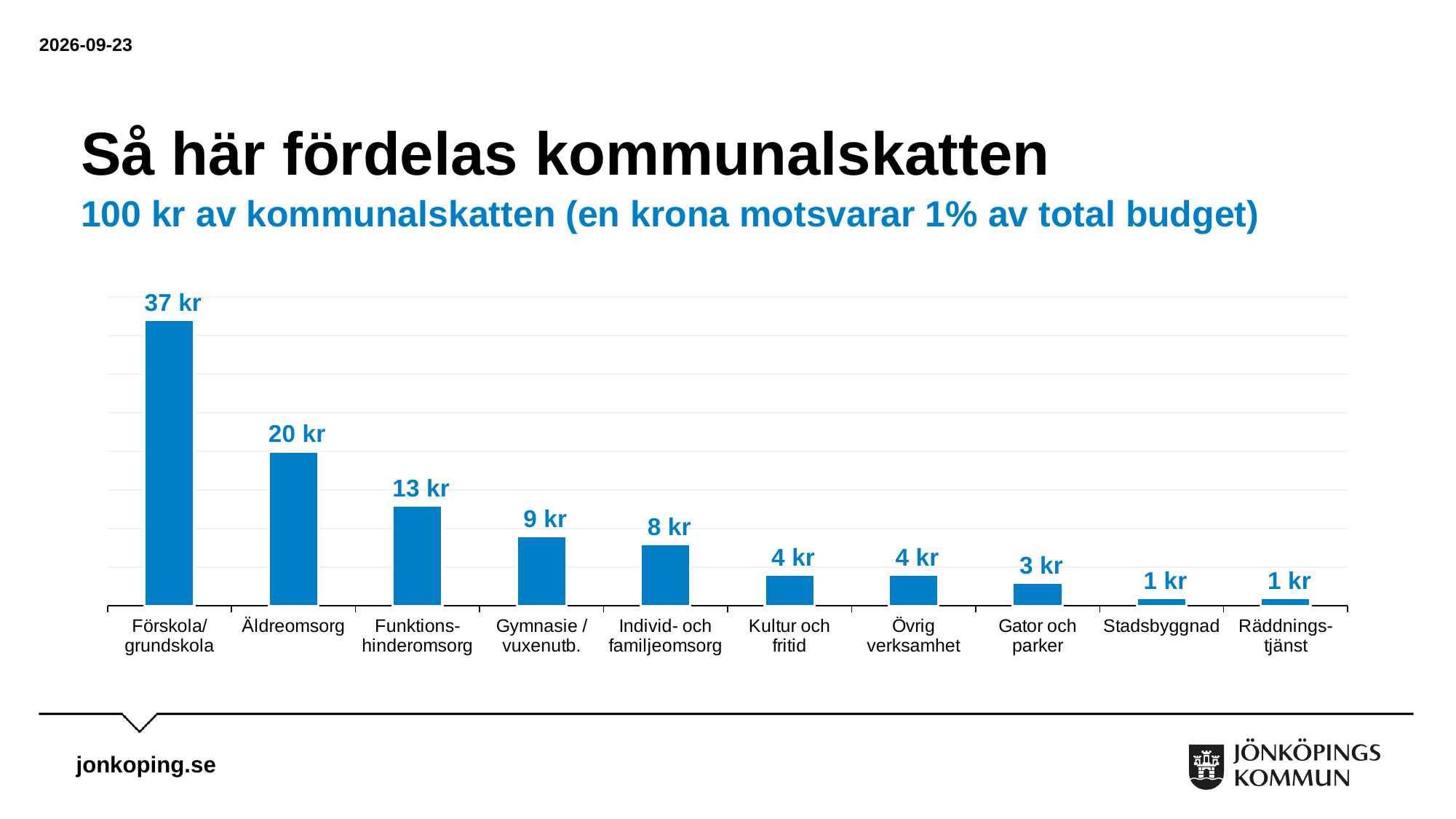
Which is larger, Gymnasie / vuxenutb. or Individ- och familjeomsorg? Gymnasie / vuxenutb. How many categories are shown in the chart? 10 Do the values rise or fall from left to right along the x axis? fall What kind of chart is shown on the slide? bar chart What is the value for Äldreomsorg? 20 kr What is the value for Gator och parker? 3 kr What is the difference between Förskola/grundskola and Äldreomsorg? 17 kr What is the value for Funktionshinderomsorg? 13 kr What is the difference between Funktionshinderomsorg and Gator och parker? 10 kr What is the value for Kultur och fritid? 4 kr What is the title of the slide containing the chart? Så här fördelas kommunalskatten Which category has the highest value? Förskola/grundskola